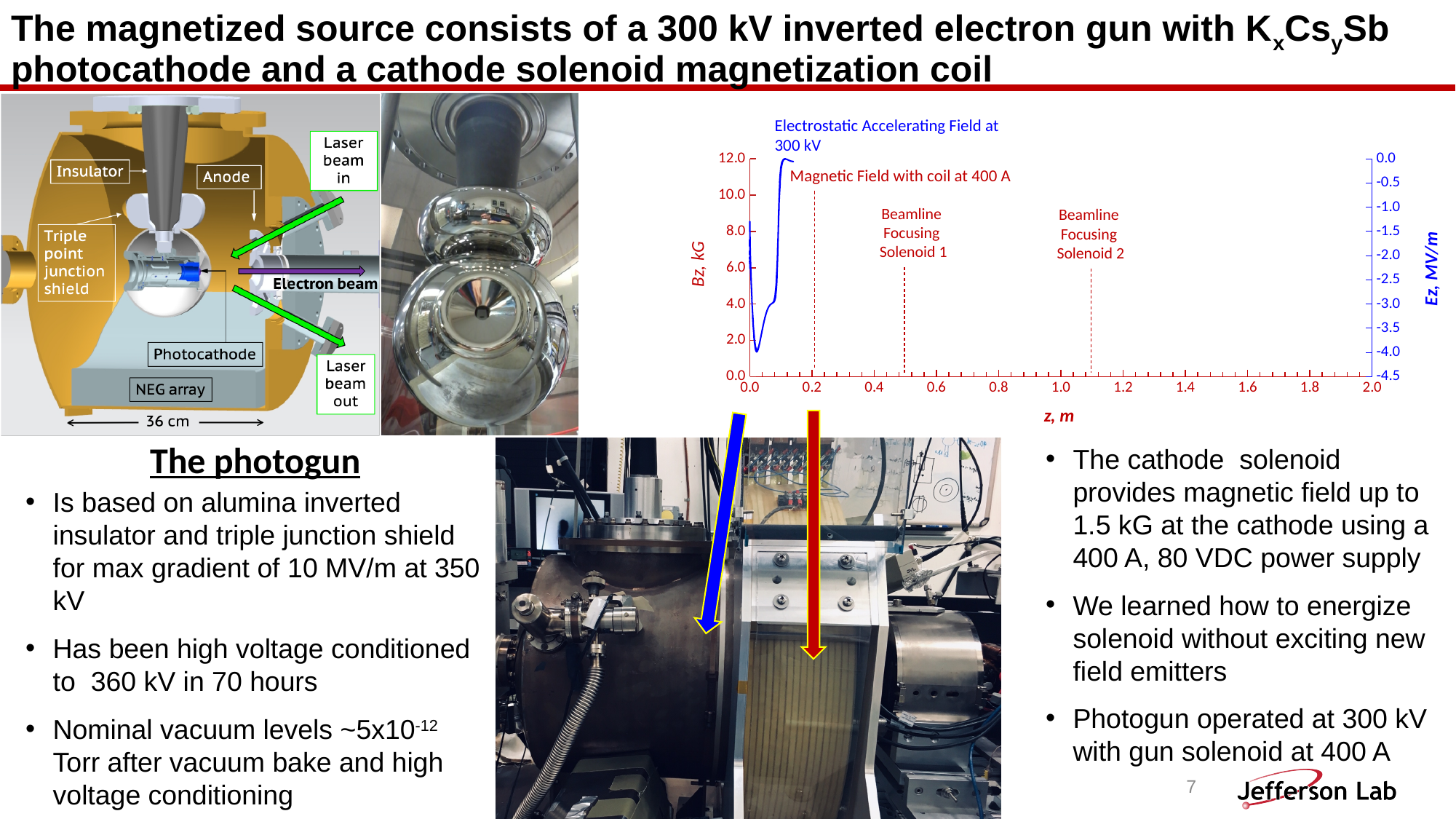
What is the label of the left vertical axis of the chart? Bz, kG Is the dashed line marking Beamline Focusing Solenoid 1 located at a z value greater or less than 0.4 m? greater Which of the two beamline focusing solenoids is located at a larger z value? Beamline Focusing Solenoid 2 According to the chart annotation, at what coil current is the magnetic field shown? 400 A According to the chart annotation, at what voltage is the electrostatic accelerating field shown? 300 kV What kind of chart is shown on the slide? line chart How many labeled tick values are there on the x axis of the chart? 11 Is the dashed line marking Beamline Focusing Solenoid 2 located at a z value greater or less than 1.0 m? greater What is the lowest tick value shown on the right vertical axis (Ez, MV/m)? -4.5 What is the label of the x axis of the chart? z, m What is the highest tick value shown on the left vertical axis (Bz, kG)? 12.0 What is the maximum value shown on the x axis of the chart? 2.0